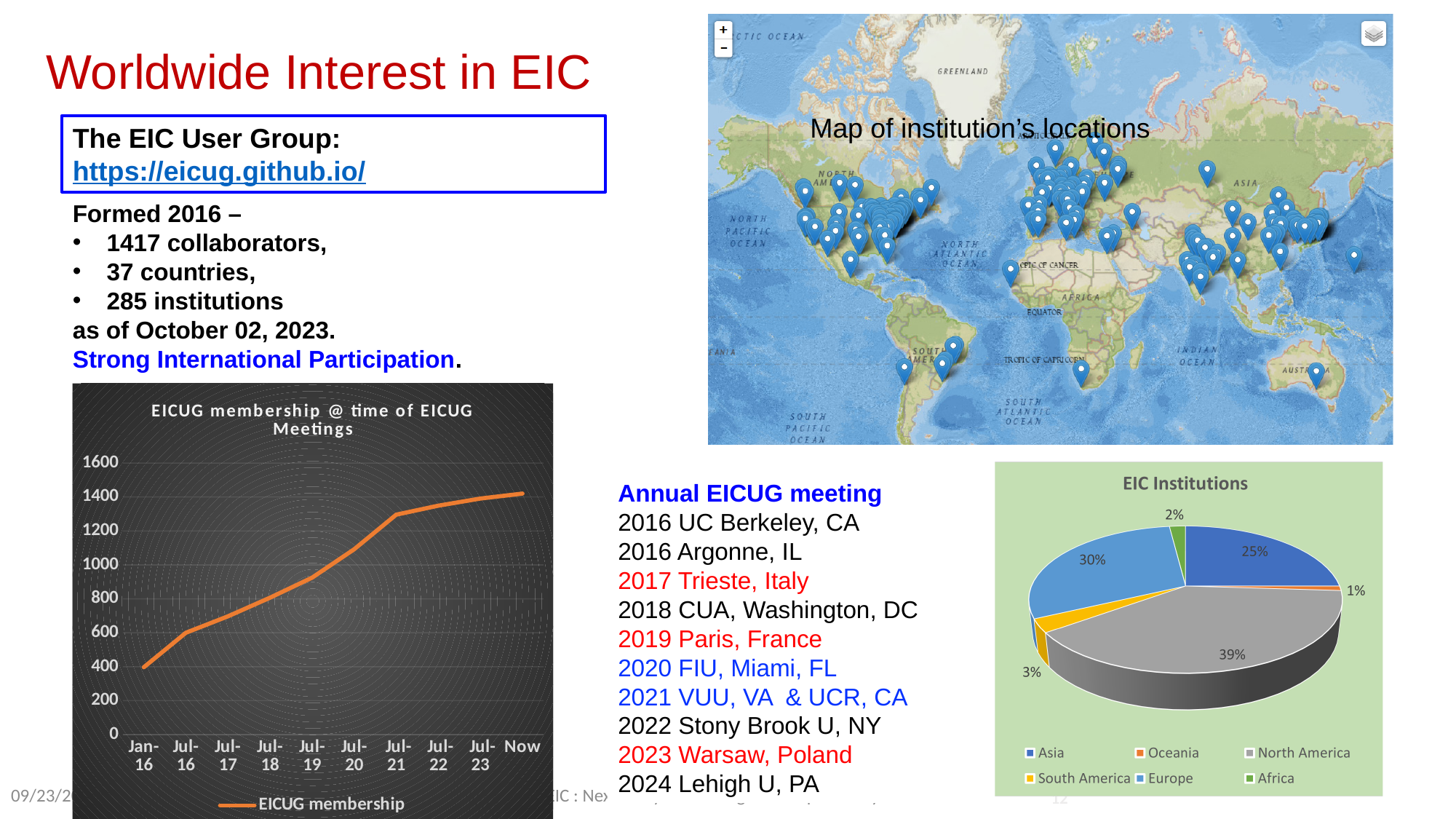
In the EIC Institutions pie chart, what share of institutions is in Europe? 30% In the EIC Institutions pie chart, which region has the largest share? North America How many regions does the legend of the EIC Institutions pie chart list? 6 In the EIC Institutions pie chart, how many percentage points larger is North America's share than Europe's? 9% In the EIC Institutions pie chart, what share of institutions is in Asia? 25% In the EIC Institutions pie chart, what share of institutions is in North America? 39% What kind of chart is the EICUG membership @ time of EICUG Meetings chart? Line chart In the EIC Institutions pie chart, which has the larger share, Asia or Europe? Europe In the EICUG membership @ time of EICUG Meetings chart, does membership rise or fall from Jan-16 to Now? Rise In the EIC Institutions pie chart, which region has the smallest share? Oceania In the EICUG membership @ time of EICUG Meetings chart, is the membership at Jul-21 greater or less than 1200? greater How many time points are plotted on the x axis of the EICUG membership @ time of EICUG Meetings chart? 10